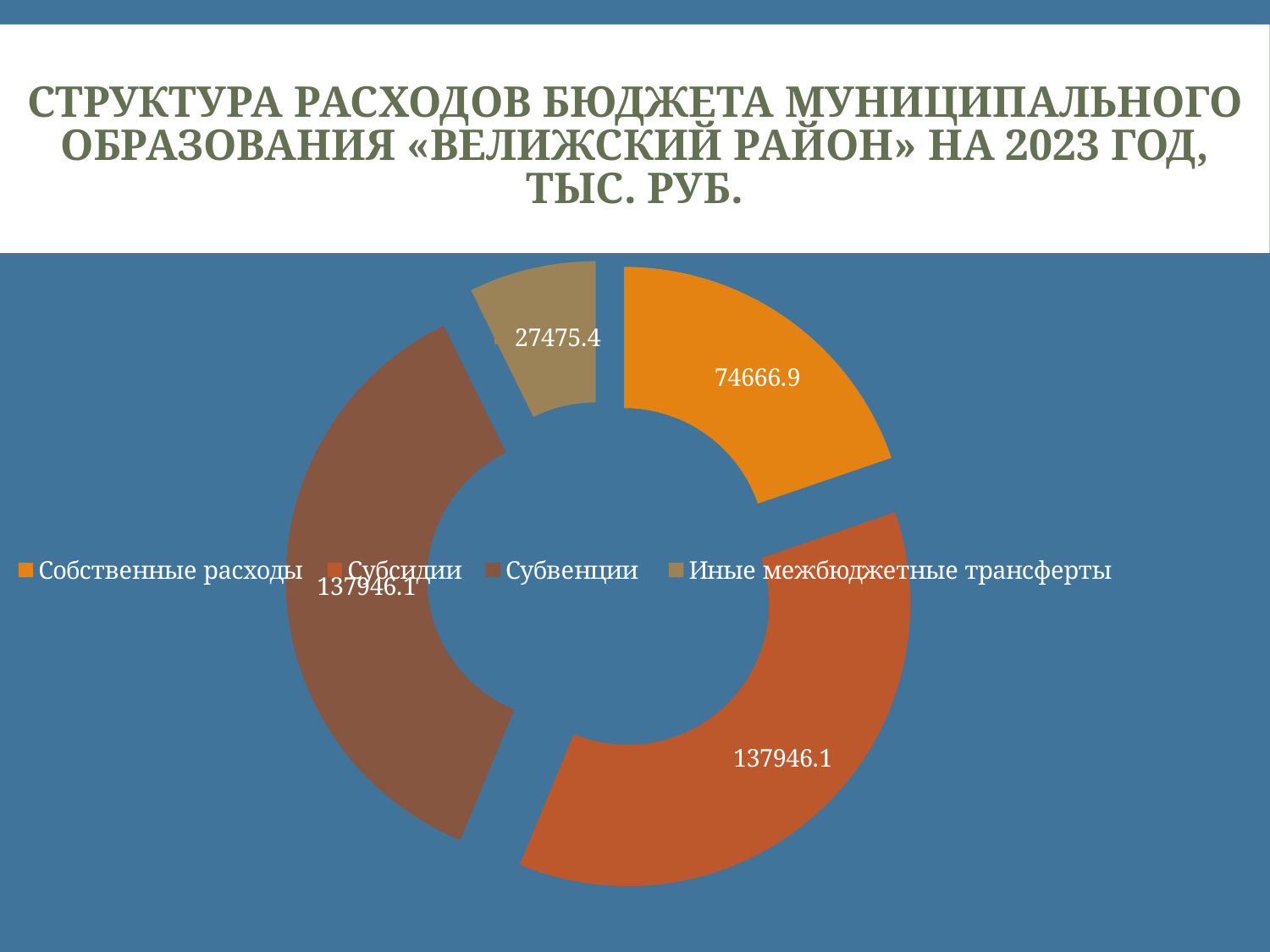
Which category is shown in orange? Собственные расходы How many entries does the legend list? 4 What is the value for Собственные расходы? 74666.9 What is the difference between the values for Субсидии and Собственные расходы? 63279.2 Which is larger, Субсидии or Собственные расходы? Субсидии Which is larger, Собственные расходы or Иные межбюджетные трансферты? Собственные расходы What is the difference between the values for Собственные расходы and Иные межбюджетные трансферты? 47191.5 How many categories does the chart show? 4 What kind of chart is shown on the slide? Doughnut (pie) chart What is the value for Иные межбюджетные трансферты? 27475.4 What is the value for Субсидии? 137946.1 Which category has the smallest value? Иные межбюджетные трансферты